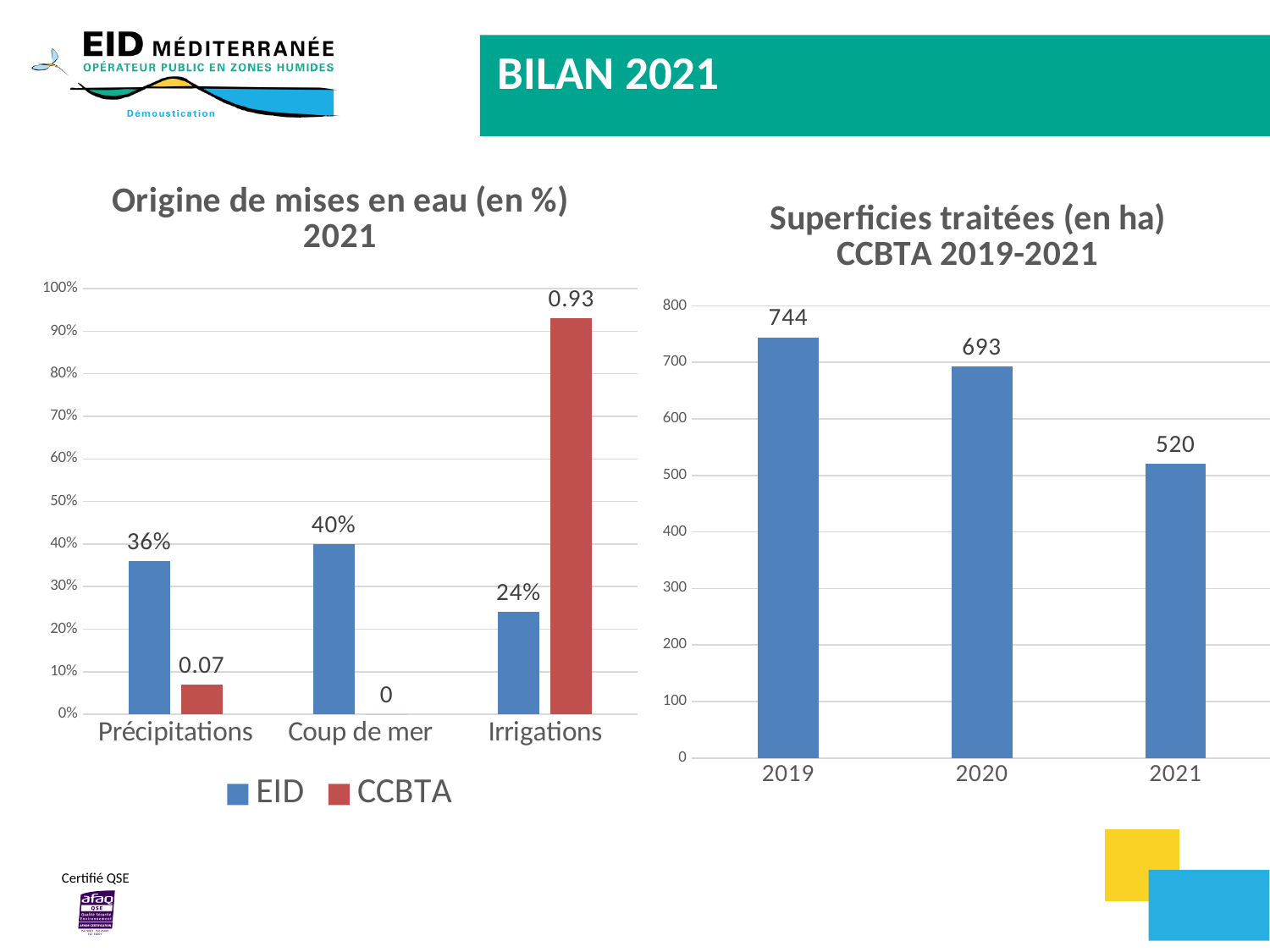
In the 'Superficies traitées (en ha) CCBTA 2019-2021' chart, which year has the lowest value? 2021 How many series does the legend of the 'Origine de mises en eau (en %) 2021' chart list? 2 In the 'Superficies traitées (en ha) CCBTA 2019-2021' chart, what is the value for 2021? 520 In the 'Origine de mises en eau (en %) 2021' chart, which is larger for Irrigations: EID or CCBTA? CCBTA In the 'Origine de mises en eau (en %) 2021' chart, what is the EID value for Coup de mer? 40% In the 'Origine de mises en eau (en %) 2021' chart, what is the CCBTA value for Coup de mer? 0 In the 'Origine de mises en eau (en %) 2021' chart, which category has the highest EID value? Coup de mer What kind of chart is the 'Superficies traitées (en ha) CCBTA 2019-2021' chart? bar chart In the 'Superficies traitées (en ha) CCBTA 2019-2021' chart, do the values rise or fall from 2019 to 2021? fall In the 'Superficies traitées (en ha) CCBTA 2019-2021' chart, what is the value for 2019? 744 In the 'Superficies traitées (en ha) CCBTA 2019-2021' chart, what is the difference between the 2019 and 2020 values? 51 In the 'Origine de mises en eau (en %) 2021' chart, what is the CCBTA value for Irrigations? 0.93